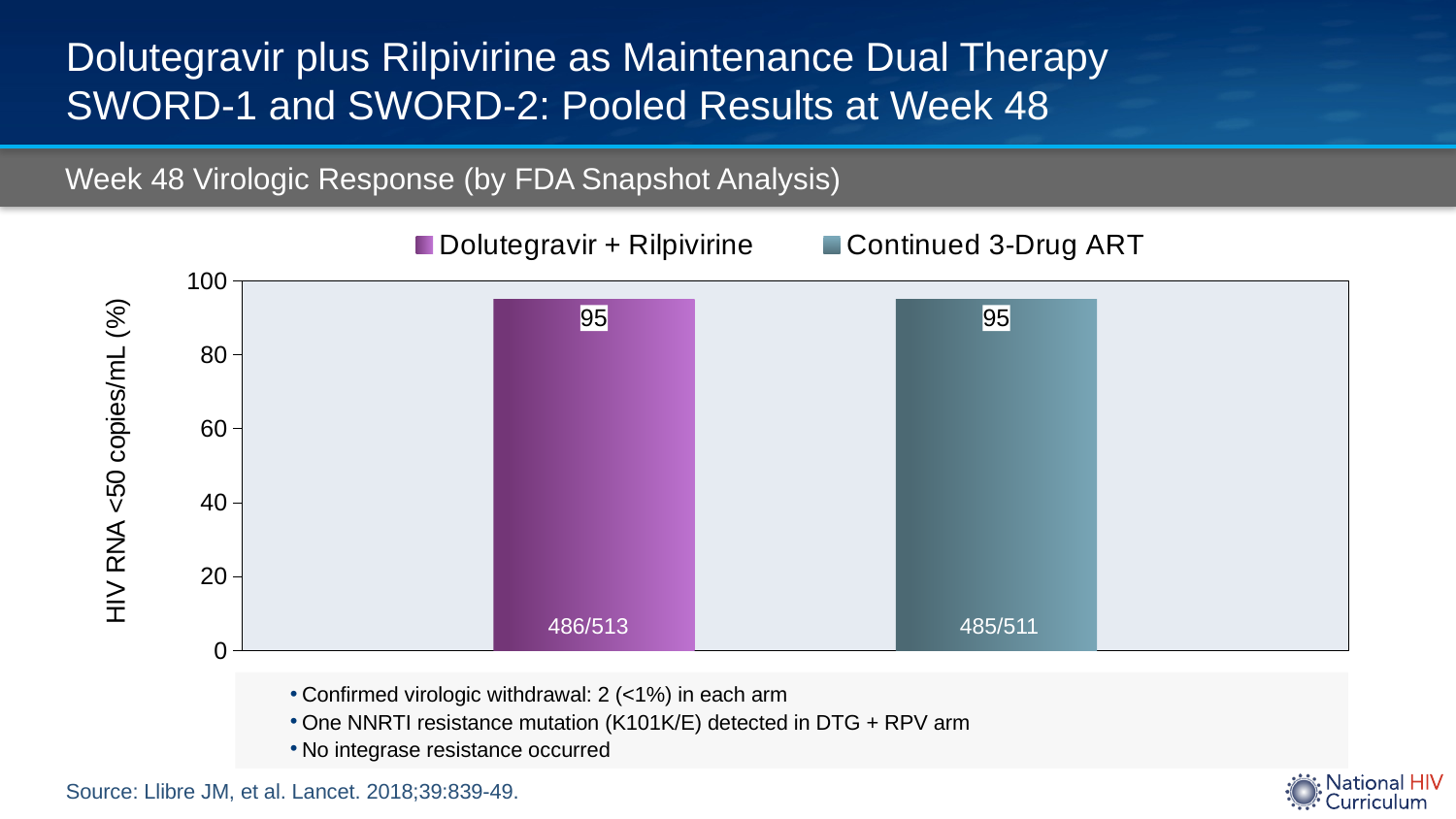
What kind of chart is shown? Bar chart What is the title of the chart? Week 48 Virologic Response (by FDA Snapshot Analysis) What is the label of the y axis? HIV RNA <50 copies/mL (%) What fraction is printed inside the Continued 3-Drug ART bar? 485/511 What is the difference between the values for Dolutegravir + Rilpivirine and Continued 3-Drug ART? 0 How many series does the legend list? 2 What is the value for Dolutegravir + Rilpivirine? 95 What fraction is printed inside the Dolutegravir + Rilpivirine bar? 486/513 What is the value for Continued 3-Drug ART? 95 Is the value for Dolutegravir + Rilpivirine greater or less than 80? greater How many bars are plotted in the chart? 2 Is the value for Continued 3-Drug ART greater or less than 60? greater